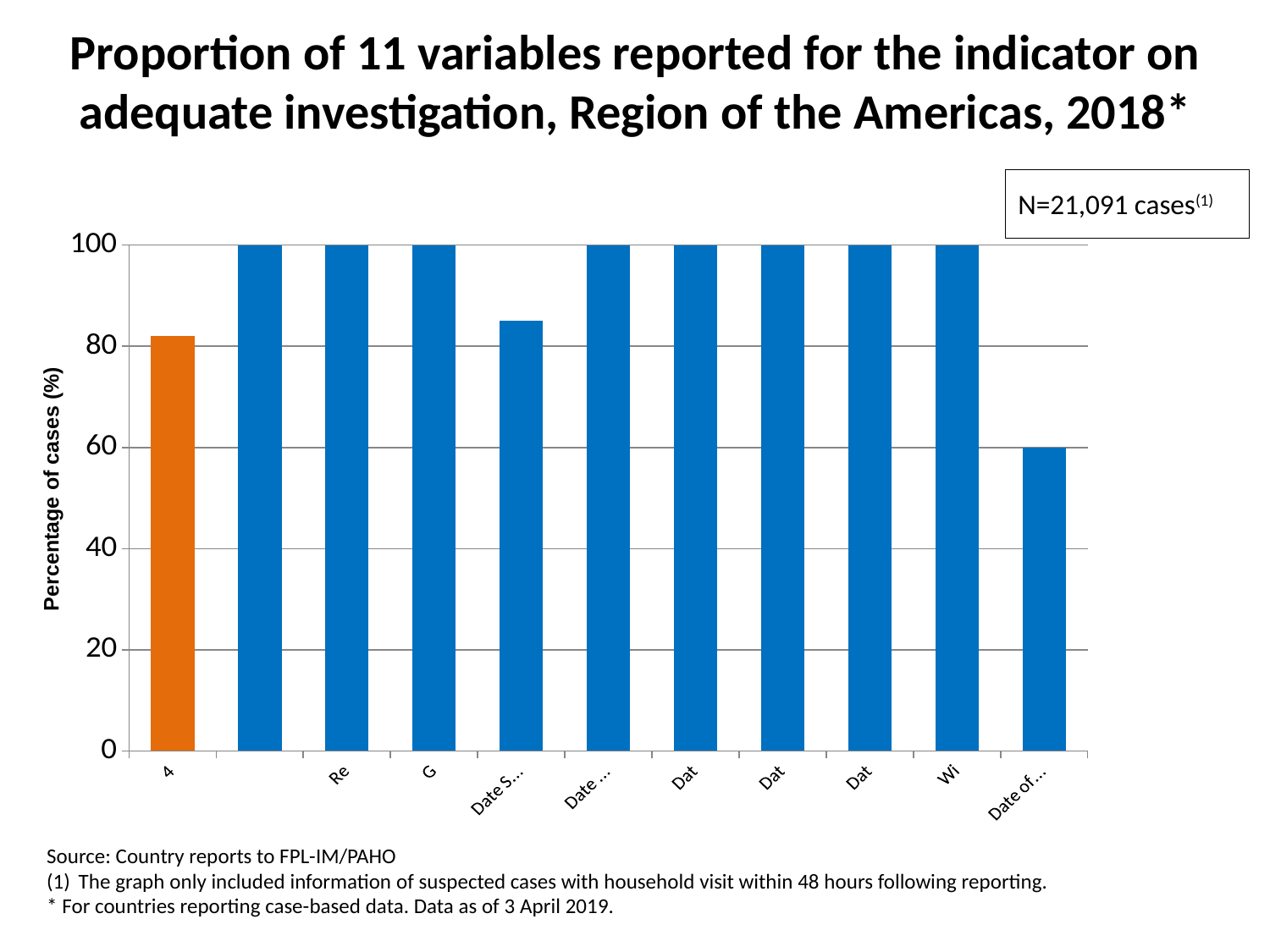
Which bar has the lowest value in the chart? the rightmost bar Is the value of the first (orange) bar greater or less than 60? greater How many bars are plotted in the chart? 11 What is the value of the rightmost bar in the chart? 60 Is the value of the rightmost bar greater or less than 80? less Which is larger, the first (orange) bar or the rightmost bar? the first (orange) bar How many bars reach 100 in the chart? 8 Is the value of the fifth bar from the left greater or less than 100? less What is the difference between the second bar from the left and the rightmost bar? 40 What type of chart is shown on the slide? bar chart What colour is the first bar in the chart? orange What is the value of the second bar from the left? 100